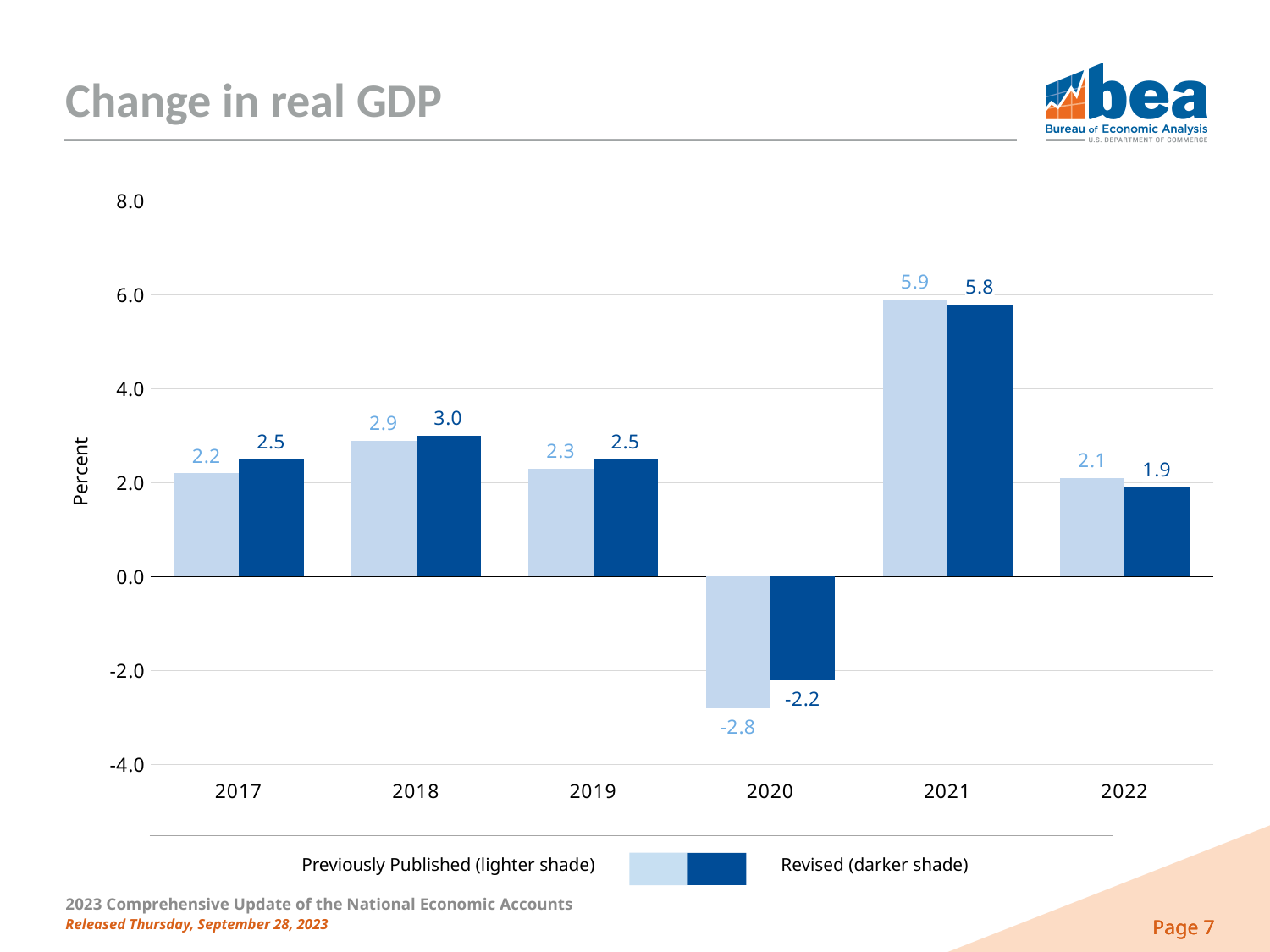
How many series does the legend list? 2 Which year has the highest revised change in real GDP? 2021 What is the previously published change in real GDP for 2020? -2.8 What is the difference between the previously published and revised values for 2021? 0.1 Which is larger for 2017, the previously published value or the revised value? Revised Which year has the lowest previously published change in real GDP? 2020 How many years are shown on the x axis? 6 What kind of chart is shown on the slide? Bar chart Is the revised value for 2021 greater or less than 4.0? greater What is the revised change in real GDP for 2018? 3.0 What is the revised value for 2022? 1.9 What is the title of the chart? Change in real GDP